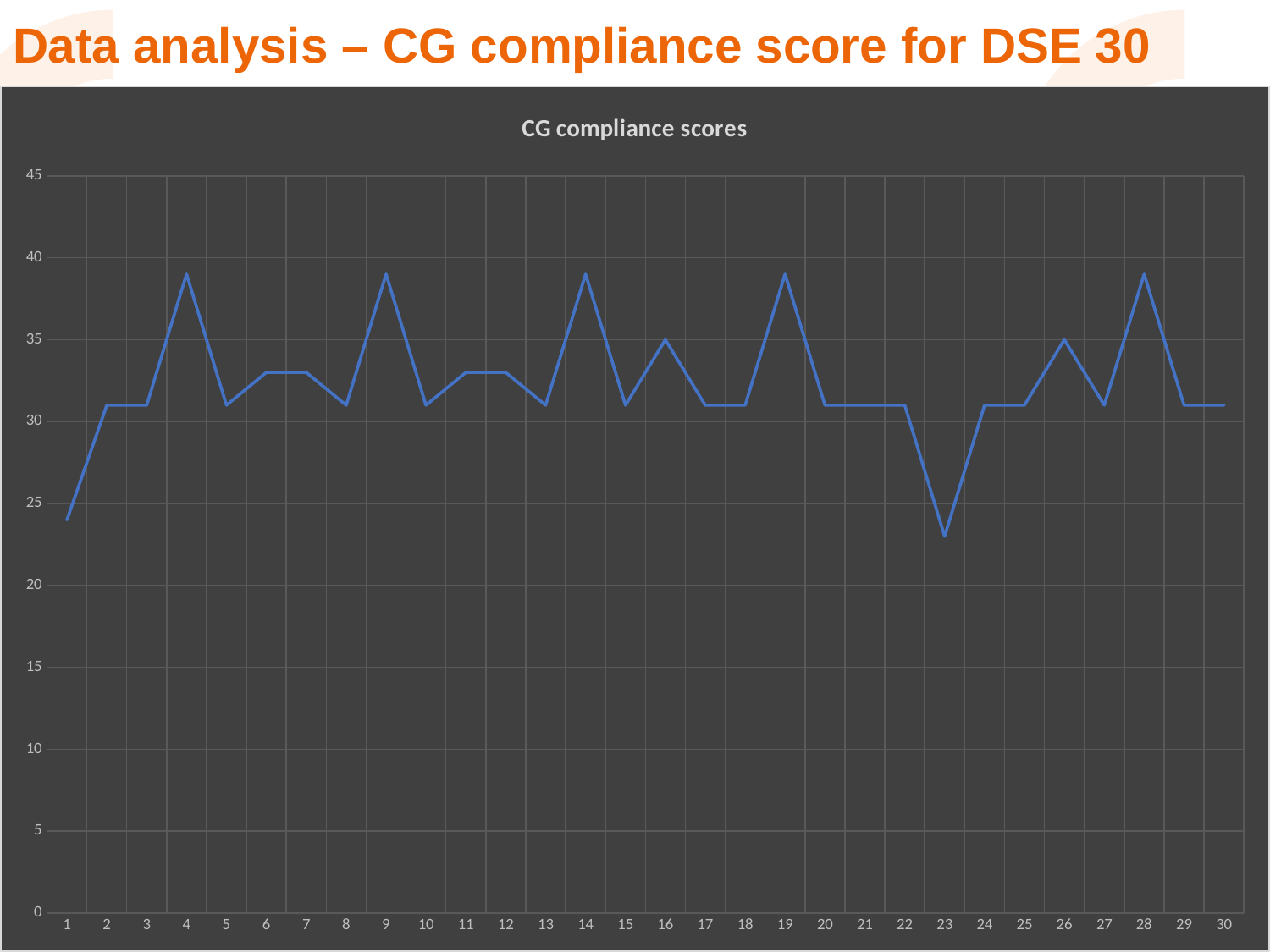
Is the value at point 16 greater or less than 30? greater Is the value at point 4 greater or less than 35? greater Which is larger, the value at point 22 or the value at point 23? point 22 Which is larger, the value at point 4 or the value at point 5? point 4 How many data points are plotted along the x axis? 30 Is the value at point 9 greater or less than 35? greater Does the line rise or fall from point 22 to point 23? fall What kind of chart is shown on the slide? line chart Does the line rise or fall from point 1 to point 4? rise What is the title of the chart? CG compliance scores